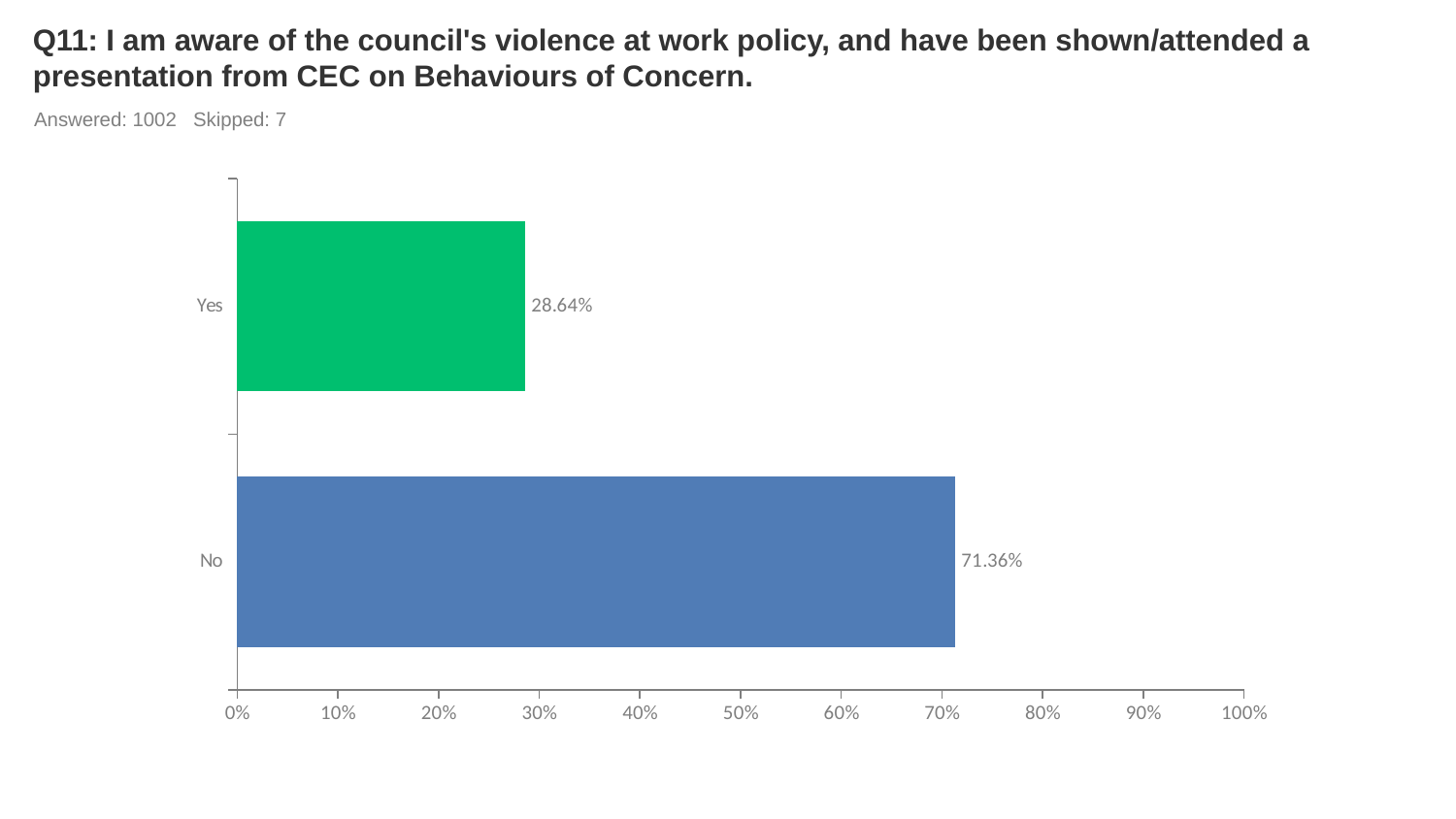
What is the total of the Yes and No percentages? 100% What type of chart is shown on the slide? Bar chart Which response category has the lowest percentage? Yes What is the difference in percentage points between the No and Yes responses? 42.72% Which is larger, the percentage for Yes or the percentage for No? No Which response category has the highest percentage? No How many response categories are shown in the chart? 2 What percentage of respondents answered No? 71.36% How many respondents answered this question? 1002 What percentage of respondents answered Yes? 28.64% Is the value for No greater or less than 70%? greater Is the value for Yes greater or less than 30%? less